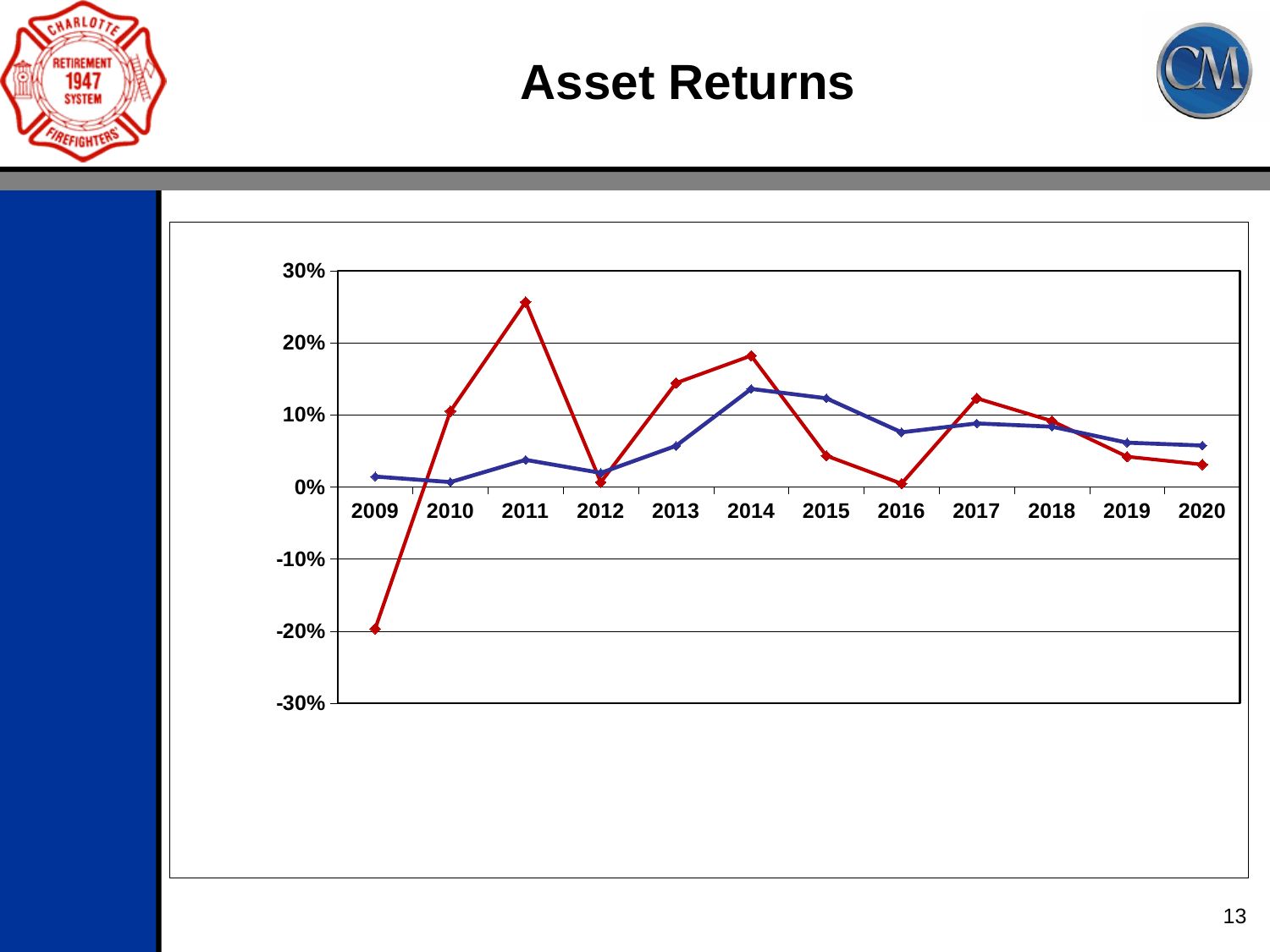
In which year does the blue line reach its highest value? 2014 Does the blue line rise or fall from 2014 to 2020? fall In which year does the red line reach its highest value? 2011 Is the value of the red line in 2011 greater or less than 20%? greater Is the value of the blue line in 2014 greater or less than 10%? greater Is the value of the red line in 2009 greater or less than -10%? less How many years are shown along the x axis of the chart? 12 What is the title of the slide containing the chart? Asset Returns How many lines are plotted on the chart? 2 In which year does the red line reach its lowest value? 2009 In 2011, which line has the higher value, the red line or the blue line? red line What kind of chart is shown on the slide? line chart